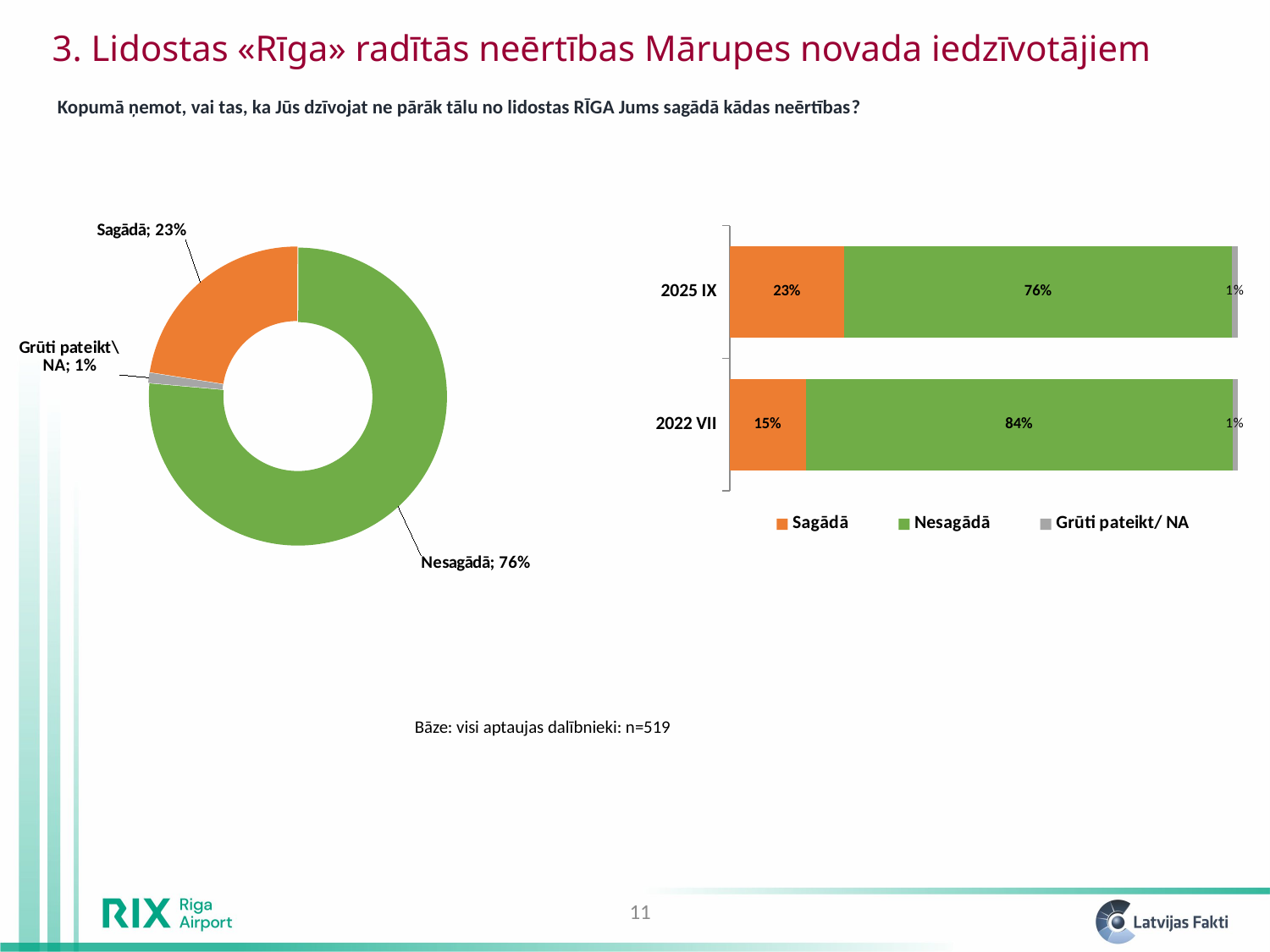
In the bar chart on the right, which period has the larger Nesagādā value, 2025 IX or 2022 VII? 2022 VII In the bar chart on the right, how many series does the legend list? 3 In the bar chart on the right, what is the total of the 2022 VII stacked bar? 100% In the doughnut chart on the left, which category has the smallest share? Grūti pateikt\ NA In the bar chart on the right, what is the value for Nesagādā in 2025 IX? 76% In the doughnut chart on the left, how many slices are there? 3 What kind of chart is shown on the right of the slide? Stacked bar chart What kind of chart is shown on the left of the slide? Doughnut chart In the doughnut chart on the left, what share is labelled for Sagādā? 23% In the bar chart on the right, what is the value for Sagādā in 2022 VII? 15% In the bar chart on the right, what is the difference between the Sagādā values for 2025 IX and 2022 VII? 8 percentage points In the doughnut chart on the left, what share is labelled for Nesagādā? 76%